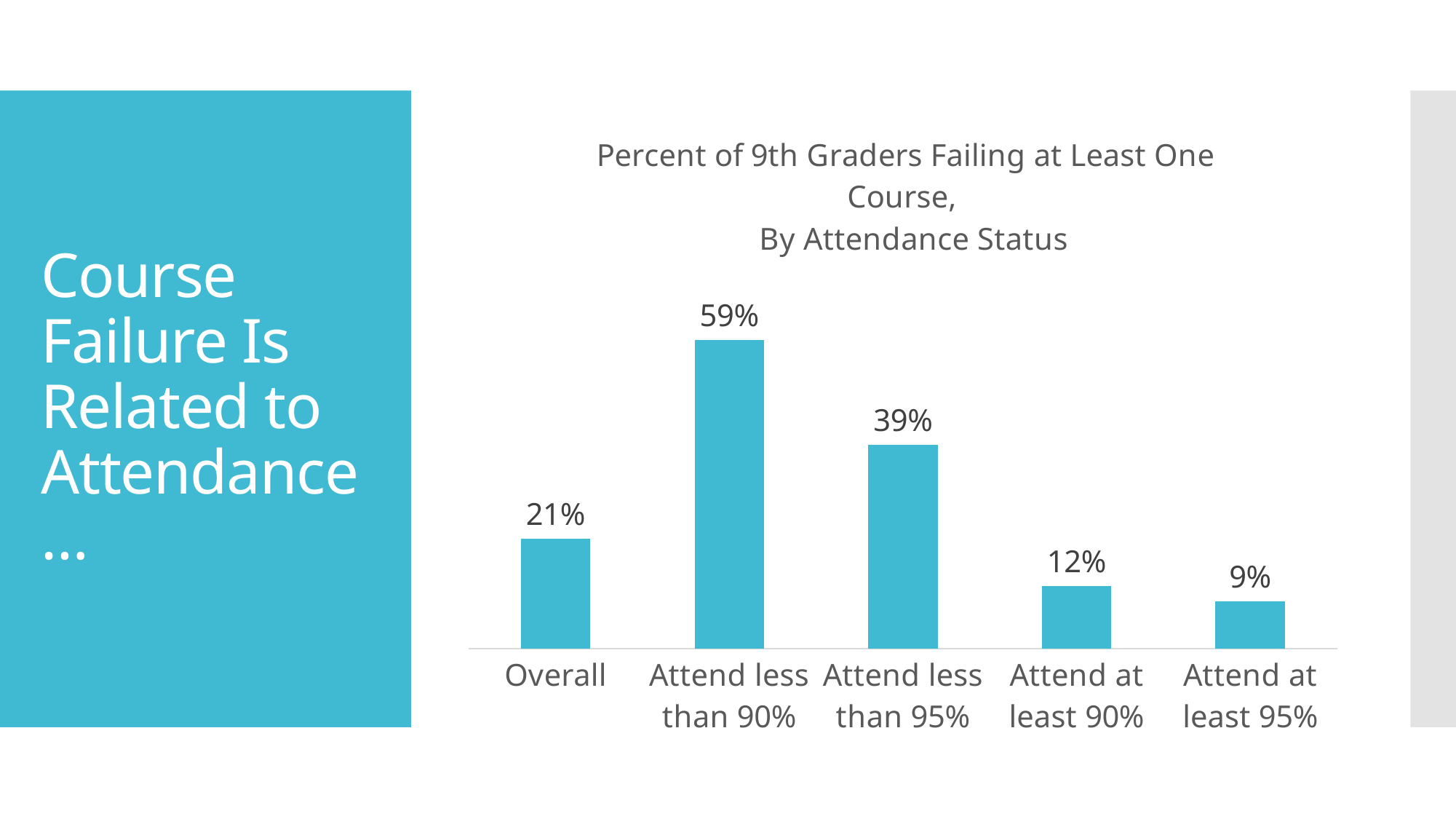
How many categories are shown in the chart? 5 Which is larger, the value for Attend at least 90% or the value for Attend at least 95%? Attend at least 90% What is the value for Attend less than 90%? 59% Which category has the highest value? Attend less than 90% Which category has the lowest value? Attend at least 95% What is the title of the chart? Percent of 9th Graders Failing at Least One Course, By Attendance Status What is the difference between the values for Attend less than 90% and Attend at least 90%? 47% What is the value for Overall? 21% What kind of chart is shown on the slide? Bar chart What is the value for Attend less than 95%? 39% What is the value for Attend at least 95%? 9% What is the difference between the values for Attend less than 95% and Overall? 18%